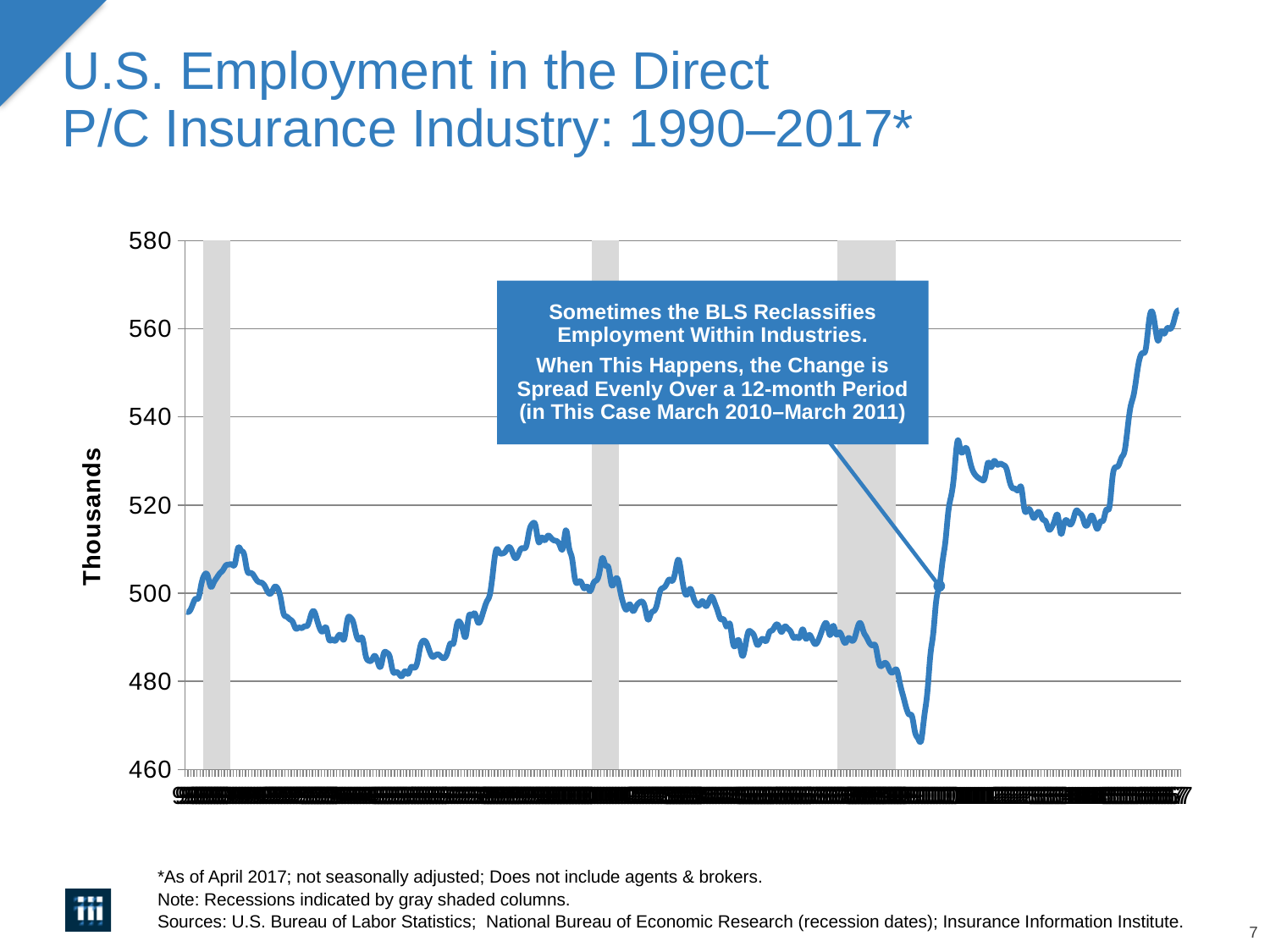
How many gray shaded recession columns appear on the chart? 3 Is the peak of the line just after the third gray shaded column greater or less than 520? greater From the lowest point of the line to the right end of the chart, does the line overall rise or fall? rise Is the value at the right end of the line greater or less than 560? greater What kind of chart is shown on the slide? line chart Is the value at the right end of the line greater or less than the value at the left end? greater What is the highest value shown on the vertical axis? 580 What is the label on the vertical axis of the chart? Thousands Is the lowest point of the line greater or less than 480? less How many data series are plotted on the chart? 1